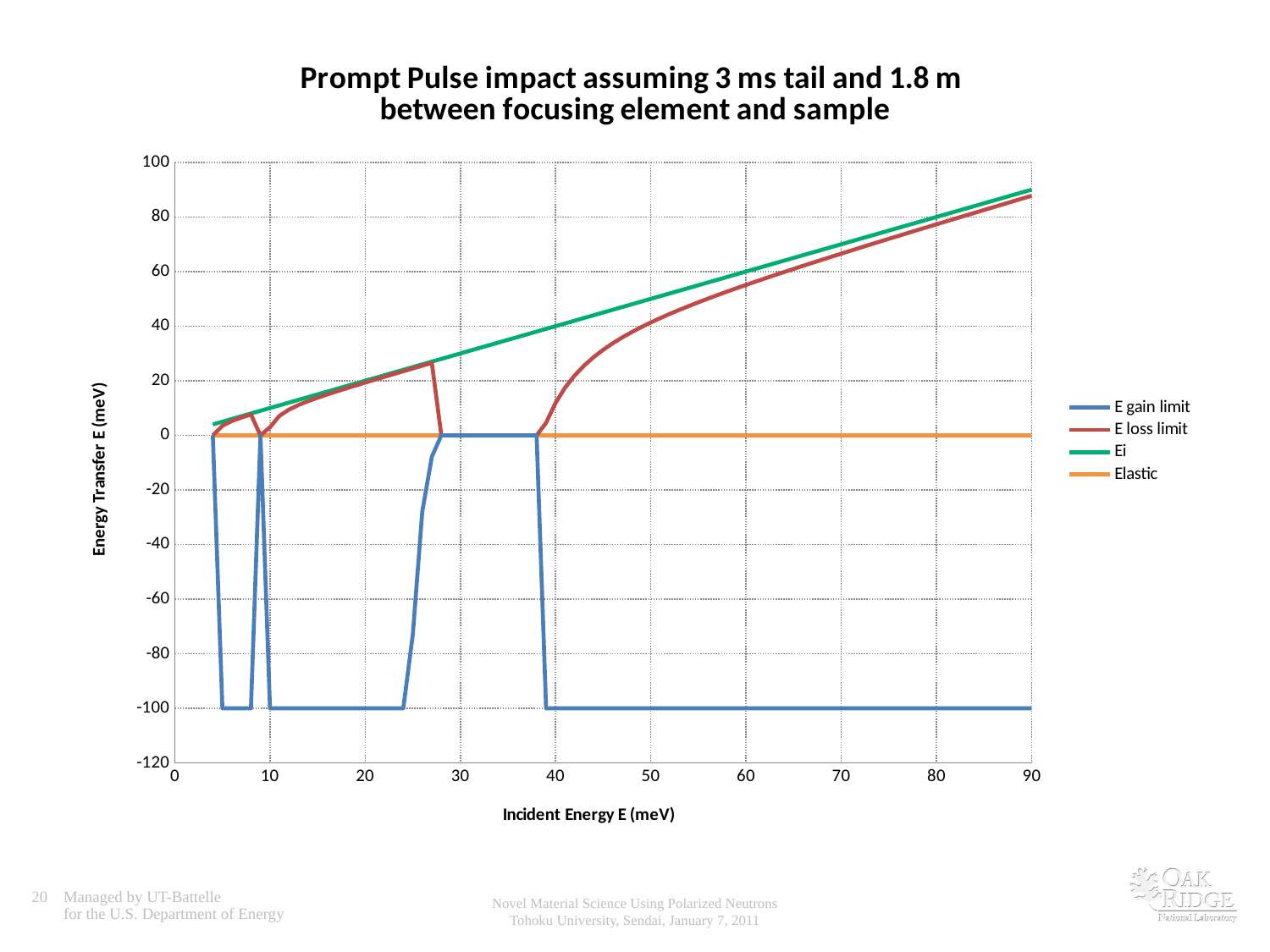
Does the Ei series rise or fall as incident energy increases? rise What is the value of the Elastic series at an incident energy of 50 meV? 0 At an incident energy of 50 meV, which is larger: Ei or the E loss limit? Ei What is the title of the chart? Prompt Pulse impact assuming 3 ms tail and 1.8 m between focusing element and sample How many series does the legend list? 4 Is the value of Ei at an incident energy of 90 meV greater or less than 80? greater Is the value of the E loss limit at an incident energy of 80 meV greater or less than 60? greater Is the value of Ei at an incident energy of 40 meV greater or less than 20? greater What kind of chart is shown on the slide? line chart What is the label of the x axis? Incident Energy E (meV) Which series has the lowest value at an incident energy of 70 meV? E gain limit What is the value of the E gain limit series at an incident energy of 60 meV? -100